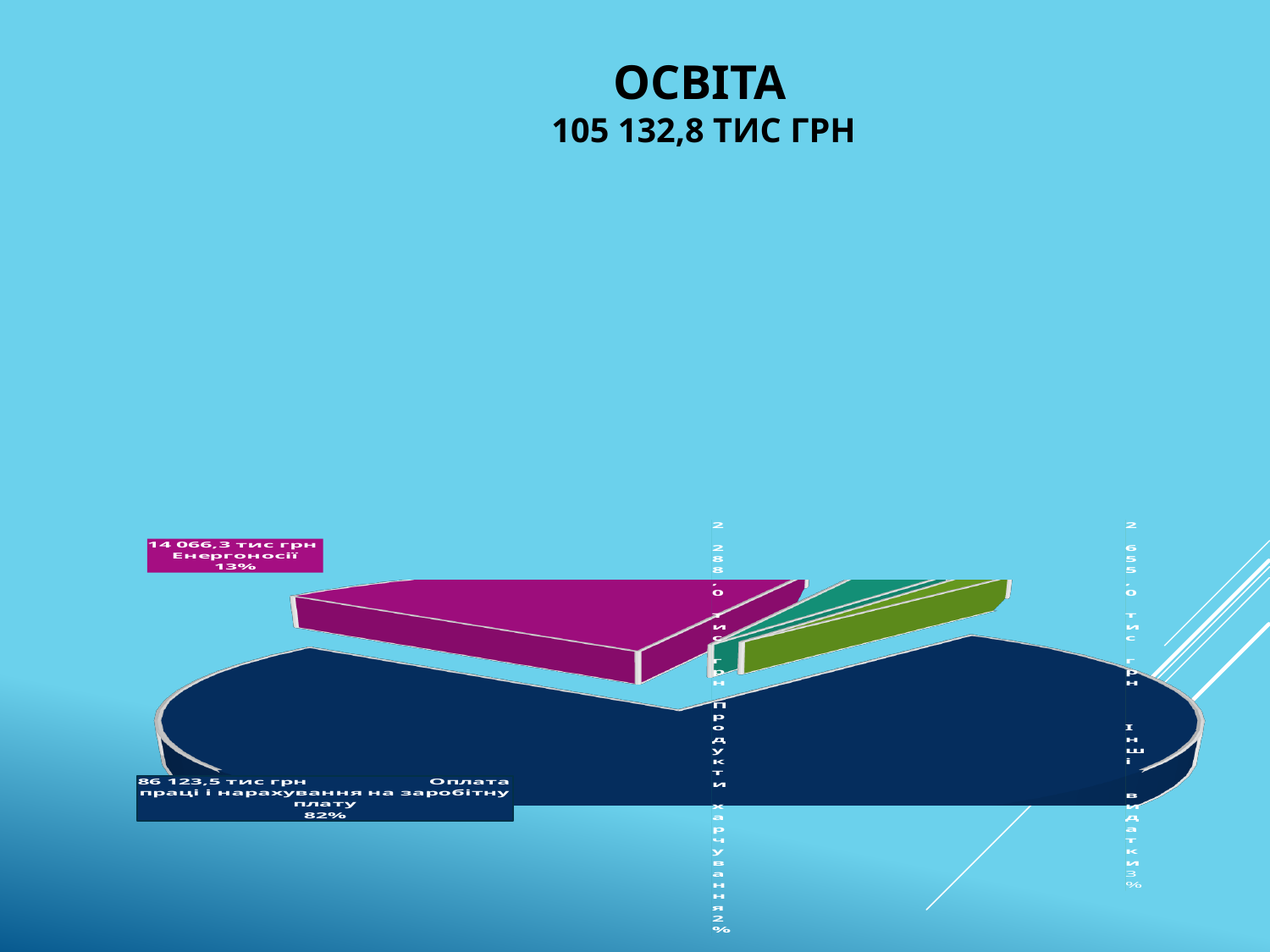
What share of the pie does Оплата праці і нарахування на заробітну плату represent? 82% What is the value shown for Енергоносії? 14 066,3 тис грн Which is larger, the value for Енергоносії or the value for Інші видатки? Енергоносії Which category has the largest slice of the pie? Оплата праці і нарахування на заробітну плату What total amount is stated under the chart title ОСВІТА? 105 132,8 ТИС ГРН What share of the pie does Інші видатки represent? 3% Which category has the smallest slice of the pie? Продукти харчування What kind of chart is shown on the slide? pie chart What is the value shown for Оплата праці і нарахування на заробітну плату? 86 123,5 тис грн How many slices does the pie chart have? 4 What is the value shown for Продукти харчування? 2 288,0 тис грн What share of the pie does Енергоносії represent? 13%